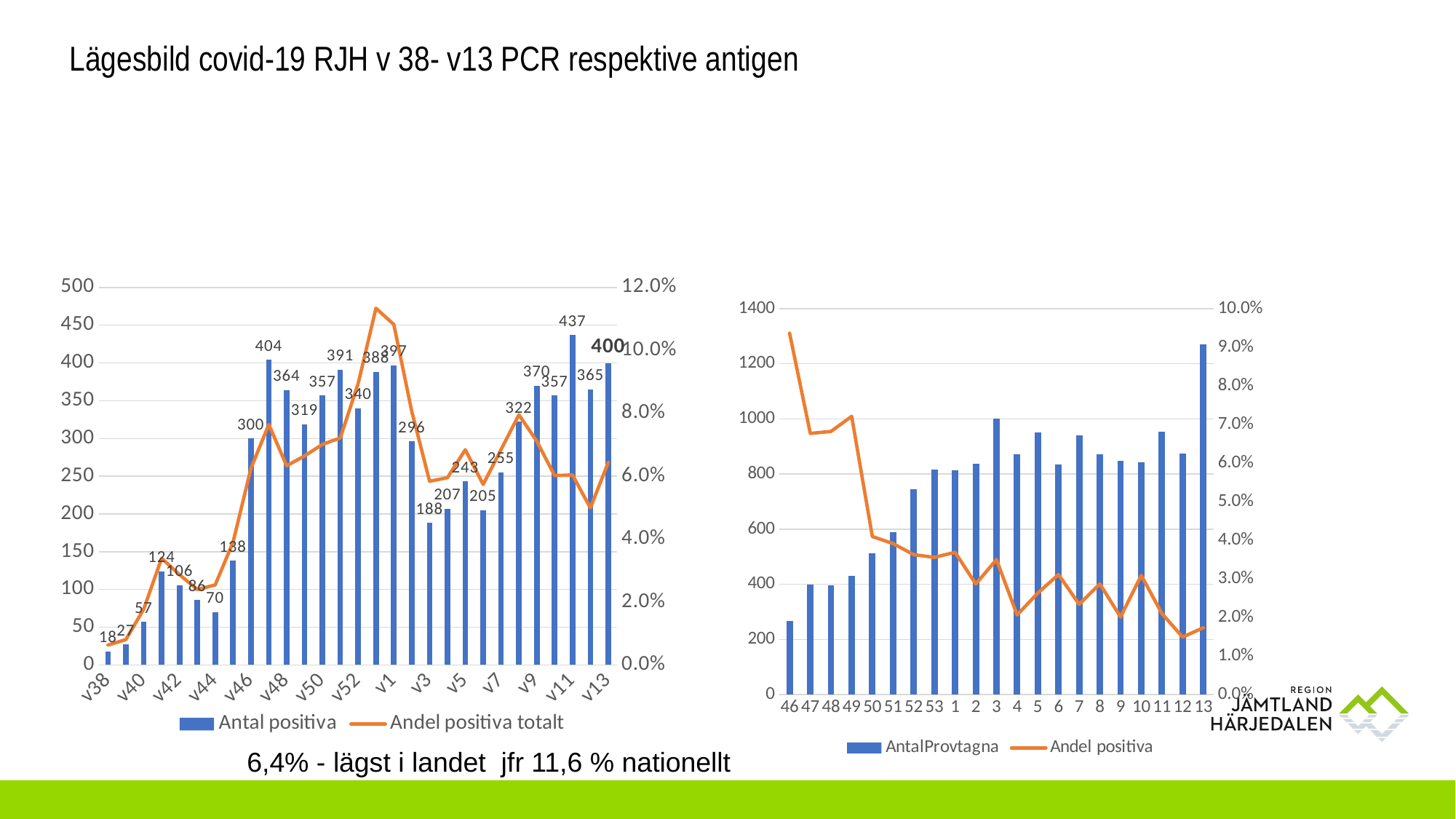
In the left chart, how many series does the legend list? 2 In the right chart, what are the two legend entries? AntalProvtagna and Andel positiva In the left chart, what is the value of Antal positiva for v11? 437 In the left chart, which week has the lowest Antal positiva? v38 In the left chart, what is the difference in Antal positiva between v11 and v13? 37 In the left chart, which has a higher Antal positiva, v9 or v3? v9 In the left chart, what is the value of Antal positiva for v46? 300 In the left chart, what is the value of Antal positiva for v13? 400 In the right chart, is the AntalProvtagna value for 46 greater or less than 400? less In the left chart, which week has the highest Antal positiva? v11 In the right chart, how many categories are shown on the x axis? 21 In the right chart, which category has the highest AntalProvtagna bar? 13